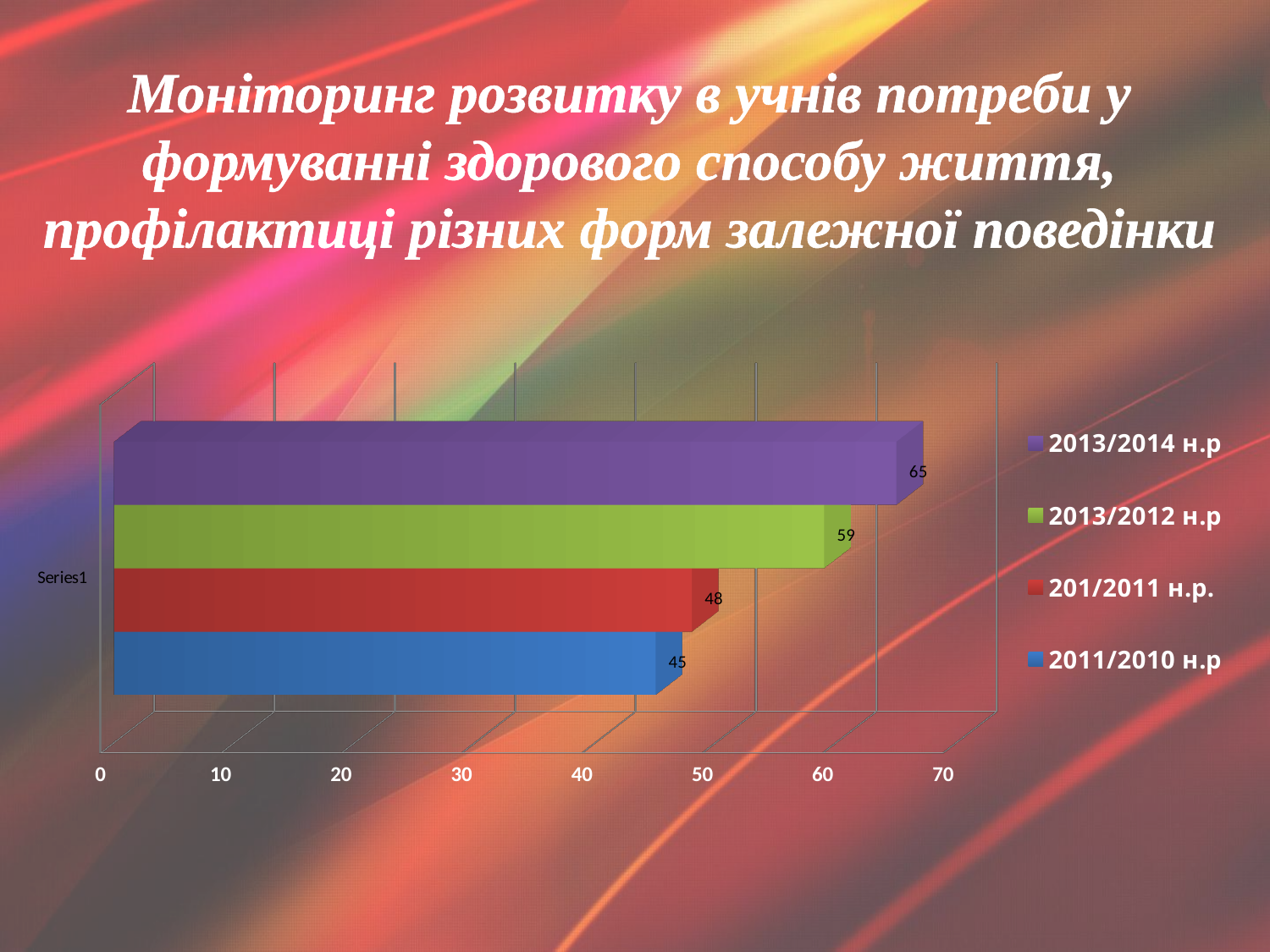
What kind of chart is shown on the slide? bar chart What is the difference between the values for 2013/2012 н.р and 201/2011 н.р.? 11 How many series does the legend list? 4 Which is larger, the value for 2013/2012 н.р or the value for 201/2011 н.р.? 2013/2012 н.р Which series has the highest value? 2013/2014 н.р What is the value for 201/2011 н.р.? 48 Is the value for 2013/2014 н.р greater or less than 60? greater Which series has the lowest value? 2011/2010 н.р What is the difference between the values for 2013/2014 н.р and 2011/2010 н.р? 20 What is the value for 2011/2010 н.р? 45 What is the value for 2013/2014 н.р? 65 What is the value for 2013/2012 н.р? 59